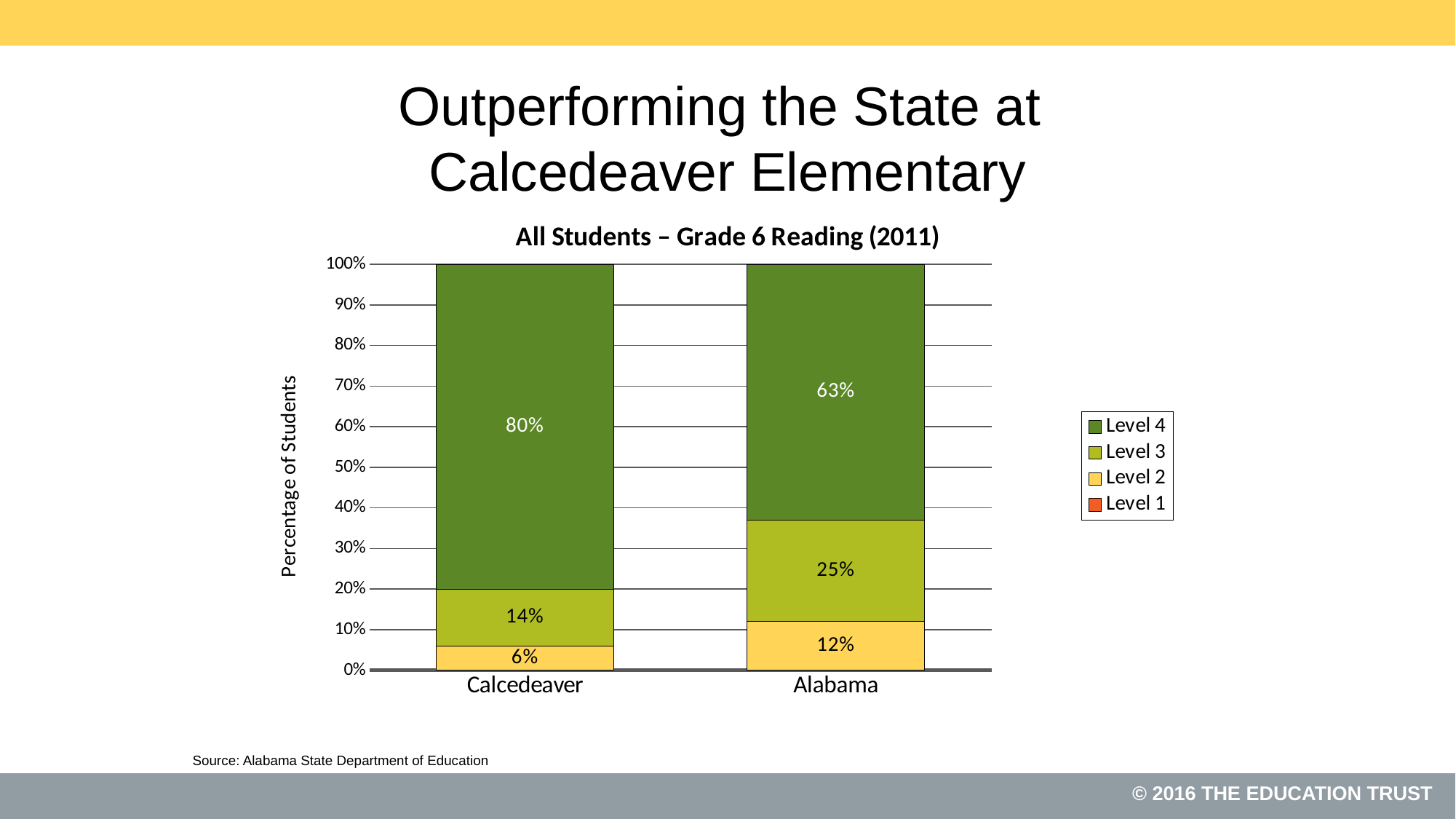
Which category has the higher Level 4 percentage, Calcedeaver or Alabama? Calcedeaver How many categories are shown on the x axis? 2 How many series does the legend list? 4 Which category has the lower Level 2 percentage? Calcedeaver What percentage of Alabama students scored at Level 3? 25% What is the difference between the Level 3 percentages for Alabama and Calcedeaver? 11% What is the title of the chart? All Students – Grade 6 Reading (2011) What percentage of Calcedeaver students scored at Level 4? 80% What percentage of Calcedeaver students scored at Level 2? 6% What is the difference between the Level 4 percentages for Calcedeaver and Alabama? 17% What kind of chart is shown on the slide? Stacked bar chart What percentage of Alabama students scored at Level 4? 63%